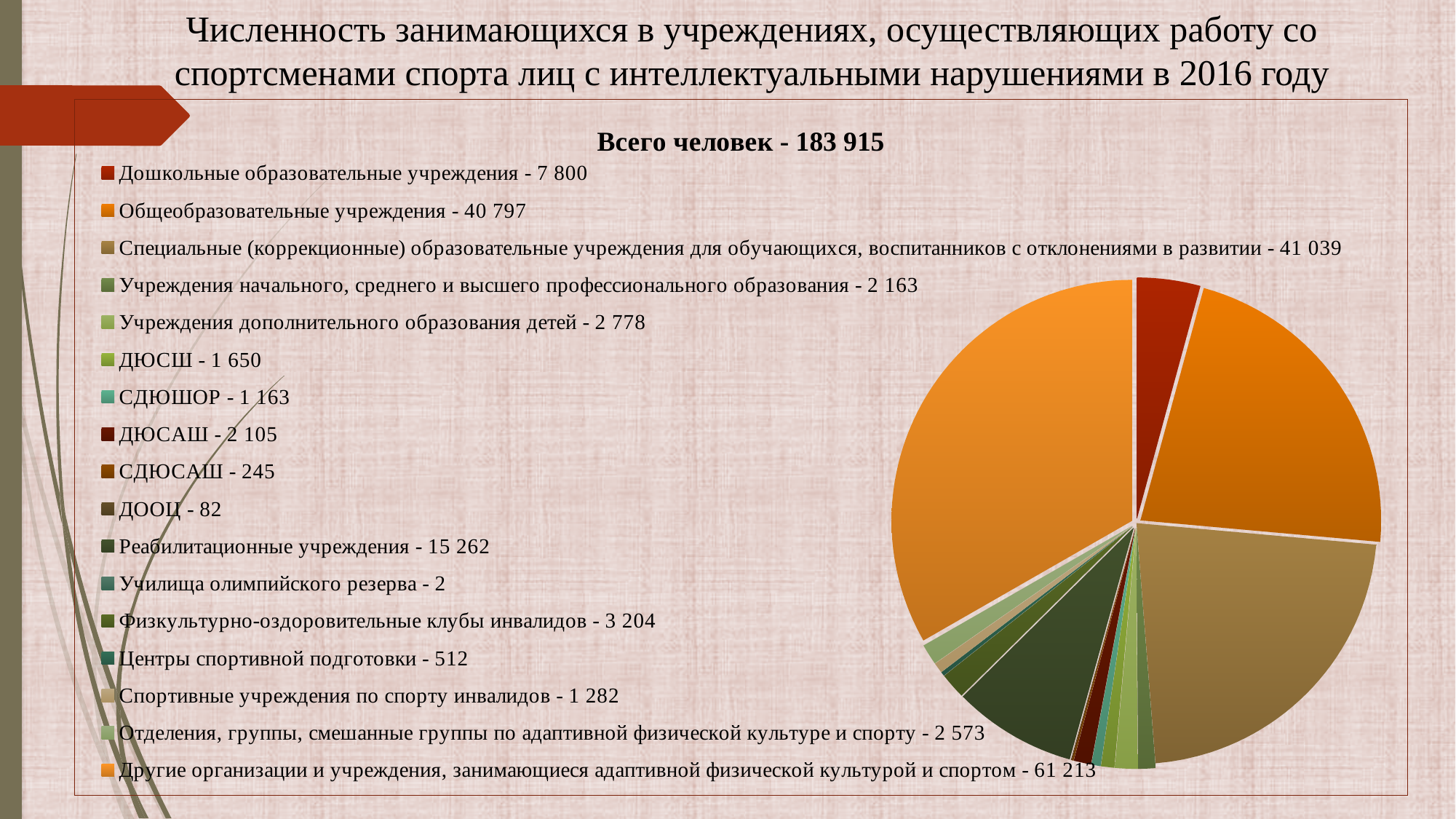
Which category has the largest value? Другие организации и учреждения, занимающиеся адаптивной физической культурой и спортом What is the value for Реабилитационные учреждения? 15 262 What share of the total do Другие организации и учреждения, занимающиеся адаптивной физической культурой и спортом represent? 33.3% What is the value for ДООЦ? 82 Which is larger, the value for ДЮСАШ or the value for ДЮСШ? ДЮСАШ What type of chart is shown on the slide? pie chart What is the total number of people given on the slide (Всего человек)? 183 915 How many categories does the legend list? 17 What is the difference between the values for Специальные (коррекционные) образовательные учреждения and Общеобразовательные учреждения? 242 Which category has the smallest value? Училища олимпийского резерва What is the value for Общеобразовательные учреждения? 40 797 What is the difference between the values for Реабилитационные учреждения and Дошкольные образовательные учреждения? 7 462